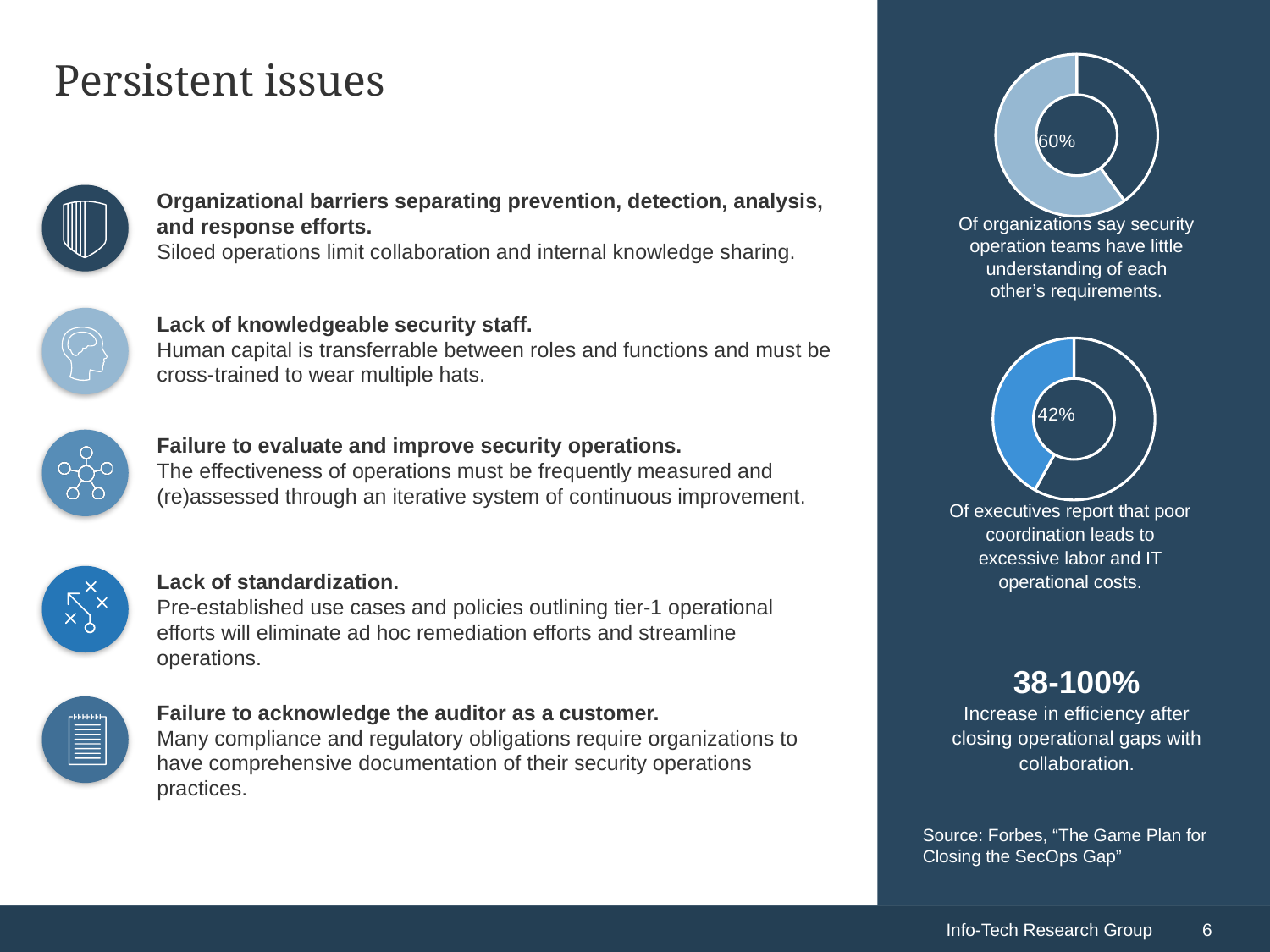
What is the difference between the value in the top donut chart (60%) and the value in the bottom donut chart (42%)? 18 percentage points Which donut chart shows the larger value, the top one (organizations) or the bottom one (executives)? The top one (60%) In the bottom donut chart, what share of the ring is not covered by the highlighted 42% segment? 58% Is the value shown in the bottom donut chart greater or less than 50%? less What value is shown in the top donut chart on the right side of the slide? 60% How many donut charts are shown on the slide? 2 What kind of chart is used to display the 60% and 42% figures on the slide? Donut chart According to the bottom donut chart, what percentage of executives report that poor coordination leads to excessive labor and IT operational costs? 42% According to the top donut chart, what percentage of organizations say security operation teams have little understanding of each other's requirements? 60% In the top donut chart, what share of the ring is not covered by the highlighted 60% segment? 40% What value is shown in the bottom donut chart on the right side of the slide? 42% What colour is the highlighted segment in the bottom donut chart? Blue